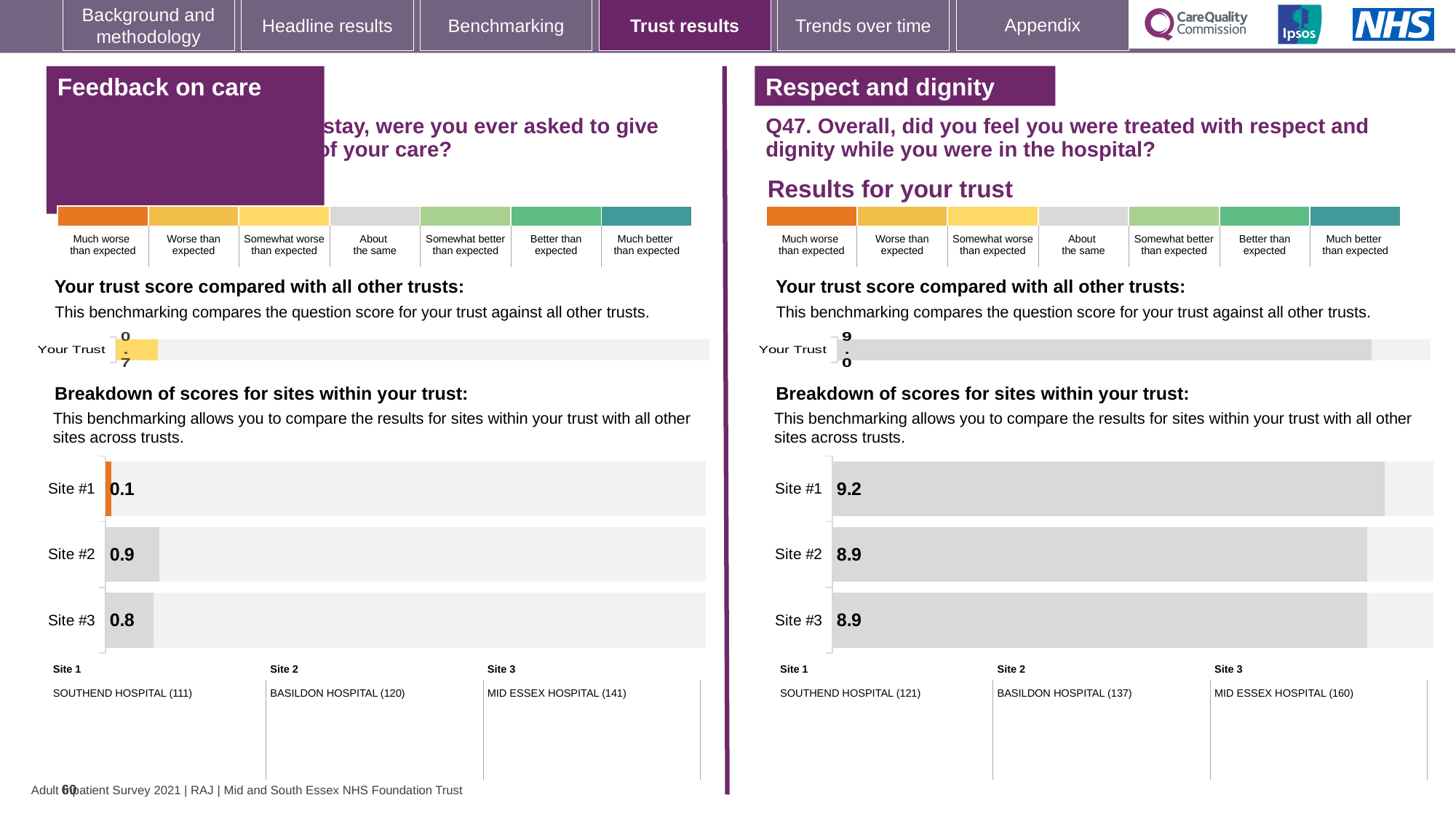
In the 'Feedback on care' site breakdown chart on the left, is the score for Site #3 larger or smaller than the score for Site #2? smaller In the 'Feedback on care' site breakdown chart on the left, what is the score for Site #2? 0.9 In the 'Respect and dignity' site breakdown chart on the right, which site has the highest score? Site #1 In the 'Respect and dignity' site breakdown chart on the right, what is the score for Site #1? 9.2 In the 'Feedback on care' site breakdown chart on the left, what is the score for Site #1? 0.1 In the 'Feedback on care' site breakdown chart on the left, what is the difference between the scores for Site #2 and Site #1? 0.8 In the 'Feedback on care' site breakdown chart on the left, which site has the highest score? Site #2 What type of chart is used for the site breakdown on the left side of the slide? bar chart How many sites are shown in the 'Respect and dignity' site breakdown chart on the right? 3 In the 'Respect and dignity' site breakdown chart on the right, what is the score for Site #3? 8.9 In the 'Respect and dignity' site breakdown chart on the right, what is the difference between the scores for Site #1 and Site #2? 0.3 In the 'Feedback on care' site breakdown chart on the left, which site has the lowest score? Site #1